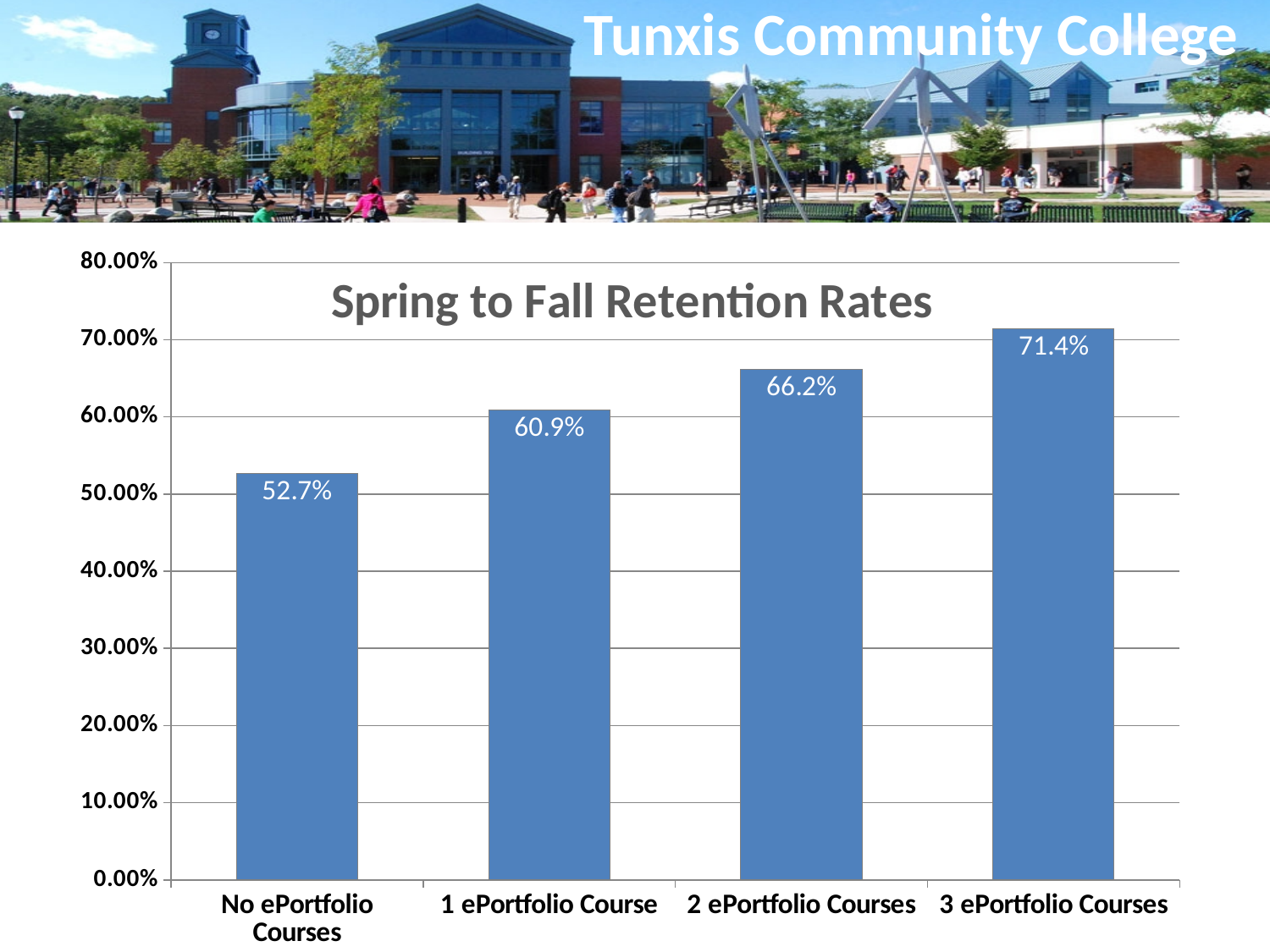
What kind of chart is shown on the slide? Bar chart Which category has the lowest Spring to Fall retention rate? No ePortfolio Courses Which category has the highest Spring to Fall retention rate? 3 ePortfolio Courses Do the retention rates rise or fall as the number of ePortfolio courses increases along the x axis? Rise What is the difference in retention rate between 2 ePortfolio Courses and 1 ePortfolio Course? 5.3% How many categories are shown in the chart? 4 What is the retention rate for students with 2 ePortfolio Courses? 66.2% What is the retention rate for students with 1 ePortfolio Course? 60.9% What is the retention rate for students with 3 ePortfolio Courses? 71.4% What is the difference in retention rate between 3 ePortfolio Courses and No ePortfolio Courses? 18.7% Which has a higher retention rate, 1 ePortfolio Course or 2 ePortfolio Courses? 2 ePortfolio Courses What is the Spring to Fall retention rate for students with No ePortfolio Courses? 52.7%